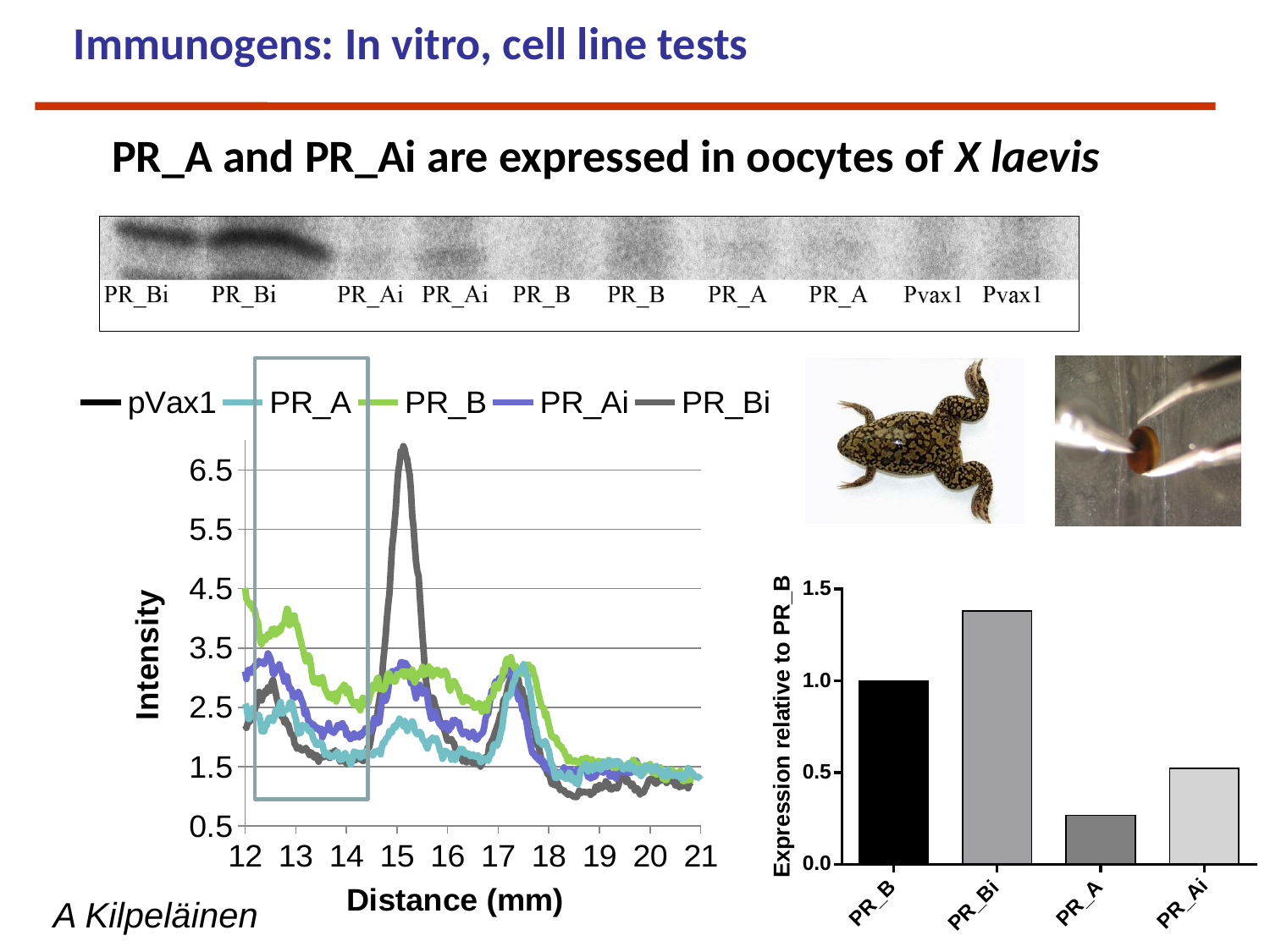
In the bar chart on the right, is the value for PR_A greater or less than 0.5? less In the line chart (Intensity vs Distance), which series has the highest peak? PR_Bi In the bar chart on the right (Expression relative to PR_B), which category has the lowest bar? PR_A In the bar chart on the right, is the value for PR_Bi greater or less than 1.0? greater How many categories are shown in the bar chart on the right? 4 How many series does the legend of the line chart (Intensity vs Distance) list? 5 In the bar chart on the right, is the value for PR_Ai greater or less than 1.0? less In the bar chart on the right, what is the expression relative to PR_B for PR_B? 1.0 What kind of chart is the chart on the right with the y-axis labelled 'Expression relative to PR_B'? bar chart What is the x-axis label of the line chart on the left? Distance (mm) In the bar chart on the right, which is larger, the value for PR_Ai or the value for PR_A? PR_Ai In the bar chart on the right (Expression relative to PR_B), which category has the highest bar? PR_Bi